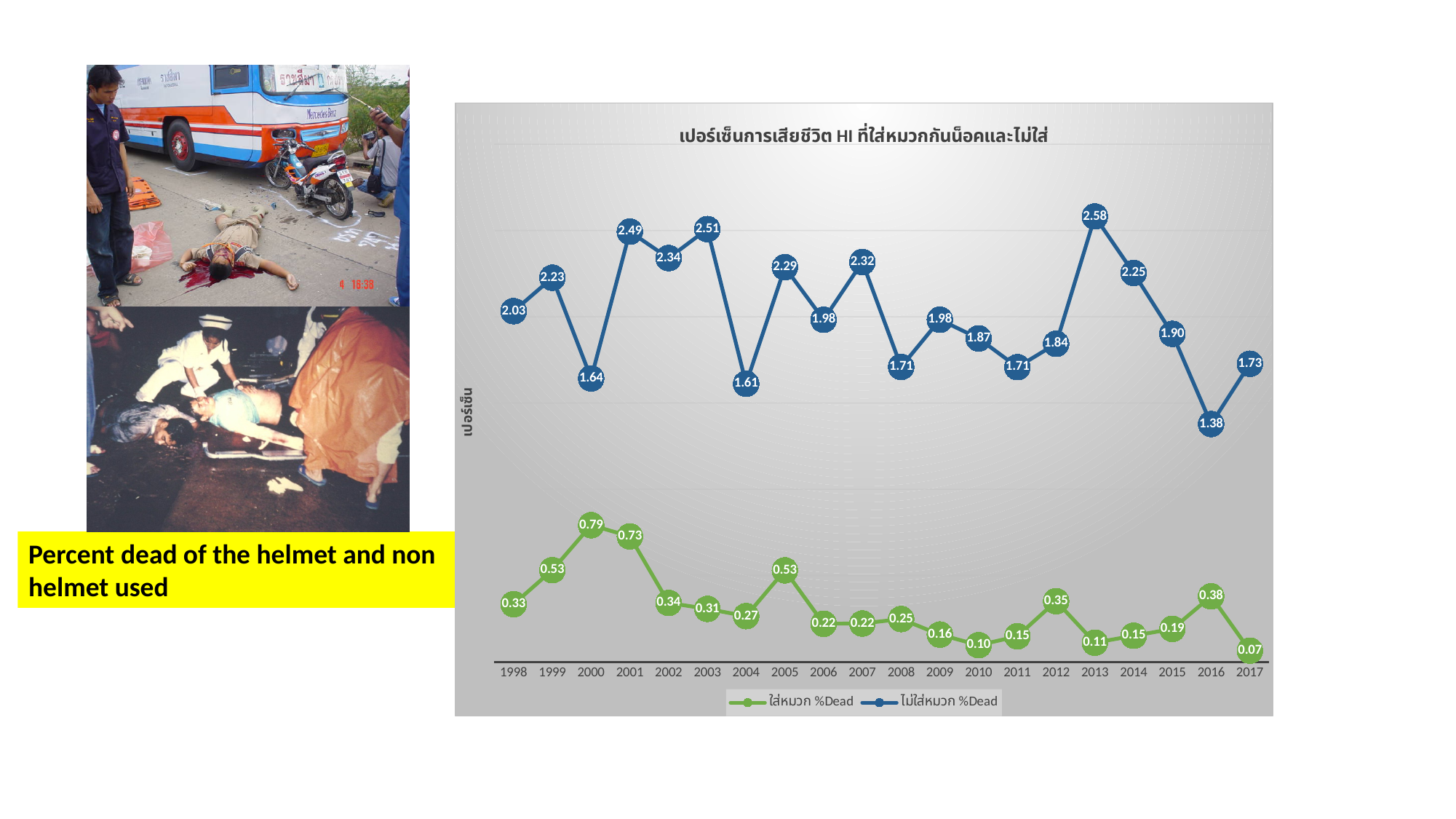
In which year is the ไม่ใส่หมวก %Dead series at its lowest? 2016 In which year is the ใส่หมวก %Dead series at its lowest? 2017 How many years are shown on the x axis? 20 In which year is the ใส่หมวก %Dead series at its highest? 2000 What is the value of the ใส่หมวก %Dead series in 2000? 0.79 What is the difference between the ไม่ใส่หมวก %Dead value and the ใส่หมวก %Dead value in 2013? 2.47 What kind of chart is shown on the slide? Line chart Which is larger for the ไม่ใส่หมวก %Dead series: the value in 2001 or the value in 2003? 2003 What is the value of the ไม่ใส่หมวก %Dead series in 2013? 2.58 What is the value of the ไม่ใส่หมวก %Dead series in 2017? 1.73 How many series does the legend list? 2 Which colour is used for the ใส่หมวก %Dead series? Green